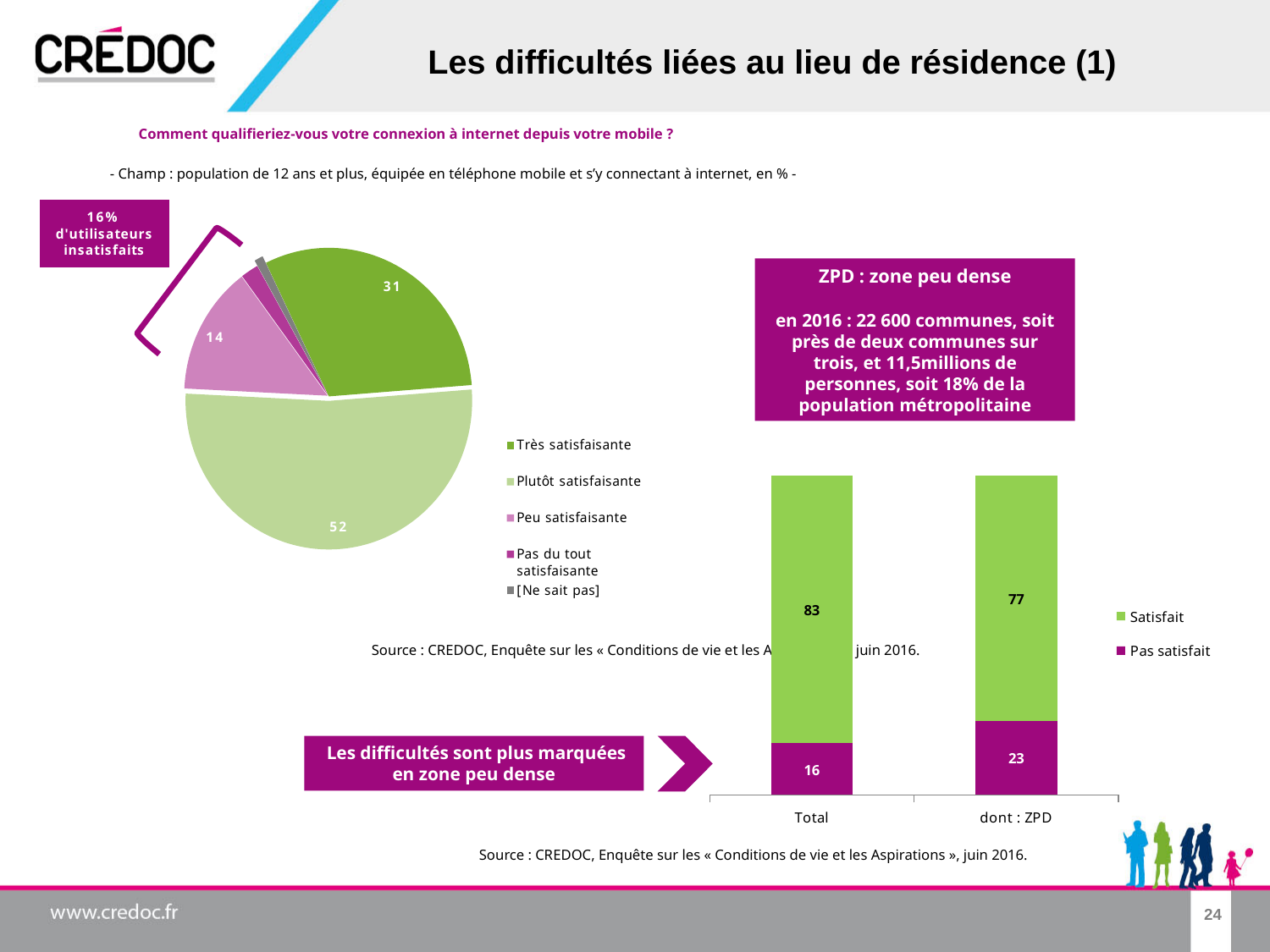
What type of chart is shown on the right side of the slide? Stacked bar chart In the pie chart on the left, what value is shown for the 'Très satisfaisante' slice? 31 In the stacked bar chart on the right, what is the 'Pas satisfait' value for 'dont : ZPD'? 23 In the pie chart on the left, what is the difference between the 'Plutôt satisfaisante' and 'Très satisfaisante' values? 21 In the pie chart on the left, what value is shown for the 'Plutôt satisfaisante' slice? 52 In the stacked bar chart on the right, what is the difference between the 'Satisfait' values for 'Total' and 'dont : ZPD'? 6 In the pie chart on the left, how many entries does the legend list? 5 In the pie chart on the left, what value is shown for the 'Peu satisfaisante' slice? 14 In the stacked bar chart on the right, what is the 'Satisfait' value for 'Total'? 83 In the pie chart on the left, which labelled slice is the largest? Plutôt satisfaisante In the stacked bar chart on the right, which category has the higher 'Pas satisfait' value, 'Total' or 'dont : ZPD'? dont : ZPD In the stacked bar chart on the right, how many series does the legend list? 2